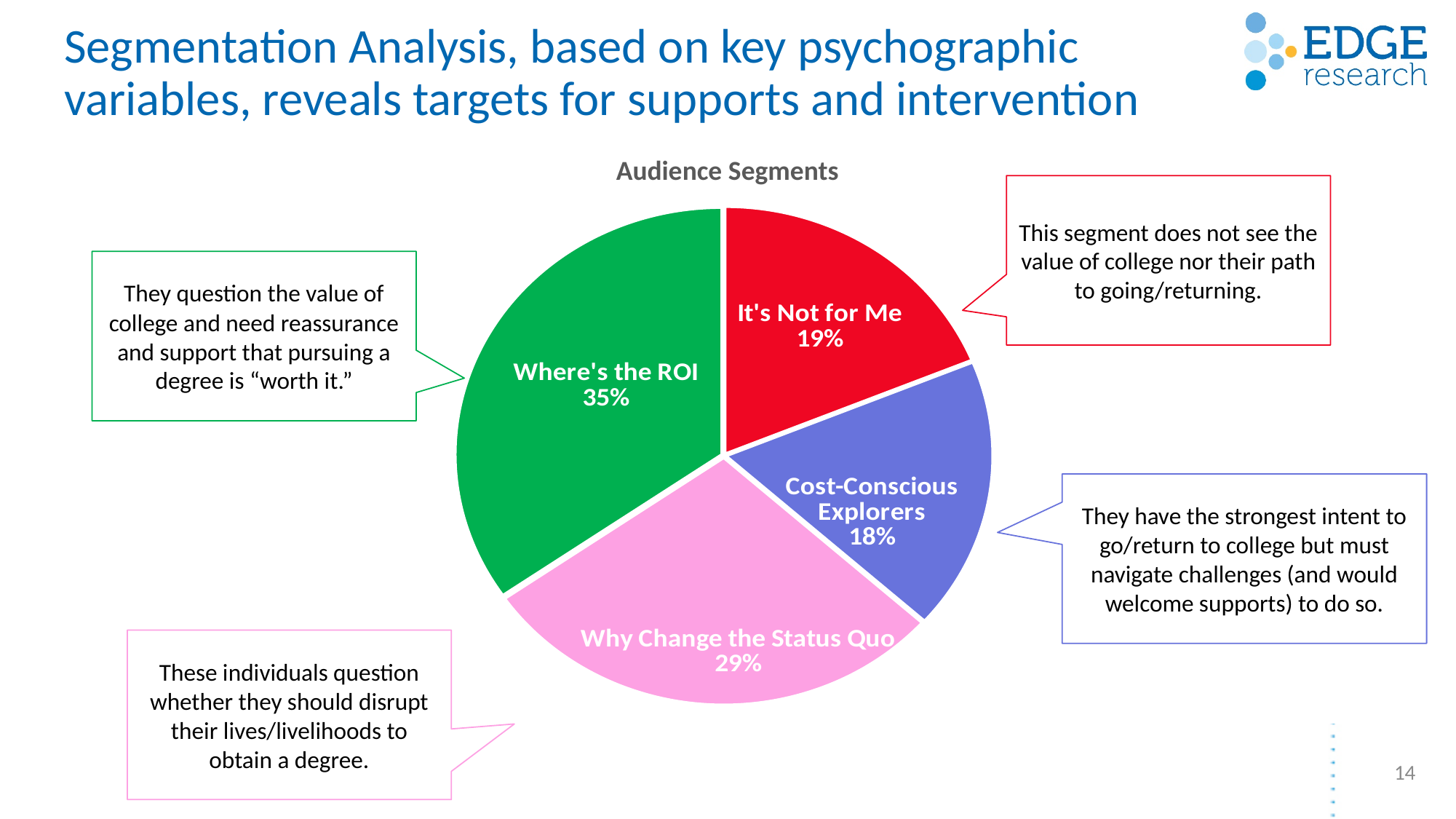
Which is larger, the share for "It's Not for Me" or the share for "Why Change the Status Quo"? Why Change the Status Quo Which segment has the largest share of the pie? Where's the ROI What is the title of the chart? Audience Segments What colour is the "Where's the ROI" slice? Green Which segment has the smallest share of the pie? Cost-Conscious Explorers How many segments does the pie chart have? 4 What share of the pie does the "Where's the ROI" segment represent? 35% What is the value shown for "Cost-Conscious Explorers"? 18% What kind of chart is shown on the slide? Pie chart What is the value shown for "Why Change the Status Quo"? 29% What is the value shown for the "It's Not for Me" segment? 19% What is the difference in percentage points between "Where's the ROI" and "Why Change the Status Quo"? 6 percentage points